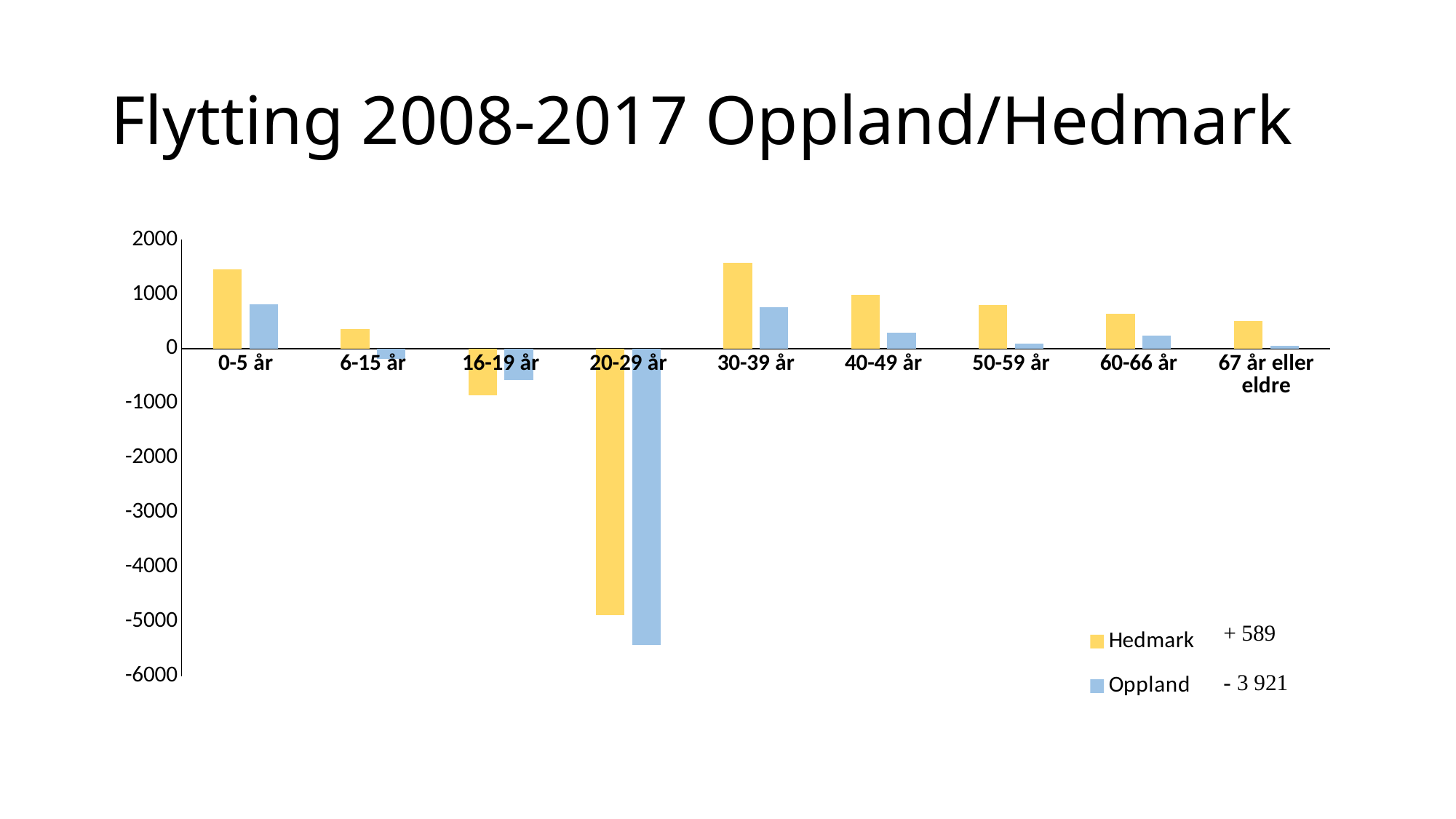
Which age category has the lowest value for Oppland? 20-29 år Is the value for Hedmark in the 16-19 år category greater or less than -500? less Is the value for Oppland in the 20-29 år category greater or less than -5000? less Which age category has the highest value for Hedmark? 30-39 år In the 0-5 år category, which series has the larger value, Hedmark or Oppland? Hedmark Which age category has the lowest value for Hedmark? 20-29 år What number is printed next to the Oppland legend entry? - 3 921 How many age categories are shown on the x axis? 9 Is the value for Hedmark in the 0-5 år category greater or less than 1000? greater What kind of chart is shown on the slide? bar chart What is the title of the slide? Flytting 2008-2017 Oppland/Hedmark How many series does the legend list? 2